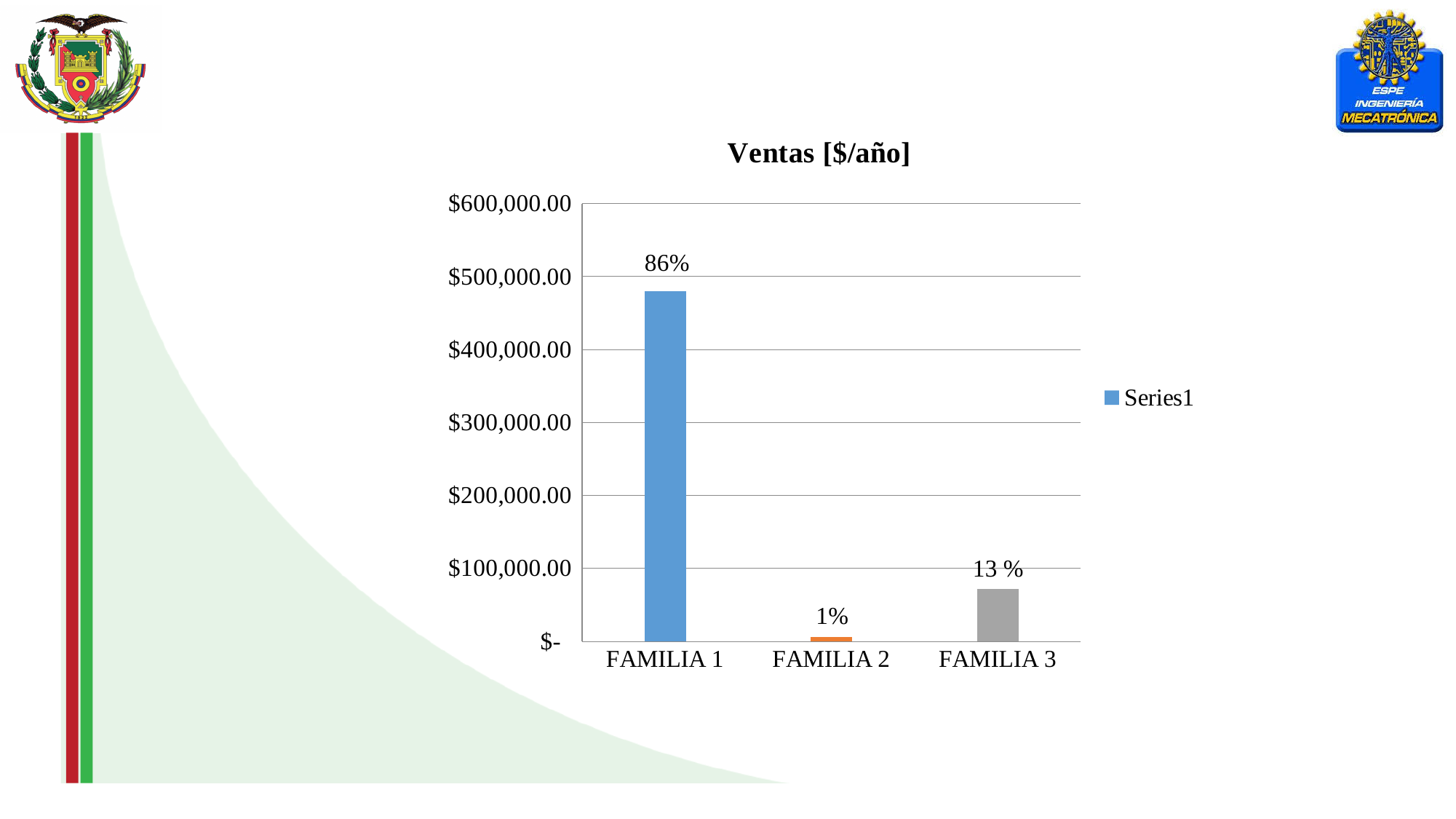
How many series does the legend list? 1 What data label is printed above the bar for FAMILIA 3? 13 % Is the value for FAMILIA 3 greater or less than $100,000.00? less Which has the larger sales value, FAMILIA 2 or FAMILIA 3? FAMILIA 3 What data label is printed above the bar for FAMILIA 2? 1% What is the title of the chart? Ventas [$/año] Which category has the lowest sales value? FAMILIA 2 What kind of chart is shown on the slide? bar chart Which category has the highest sales value? FAMILIA 1 Is the value for FAMILIA 1 greater or less than $400,000.00? greater How many categories are shown on the x axis of the chart? 3 What data label is printed above the bar for FAMILIA 1? 86%